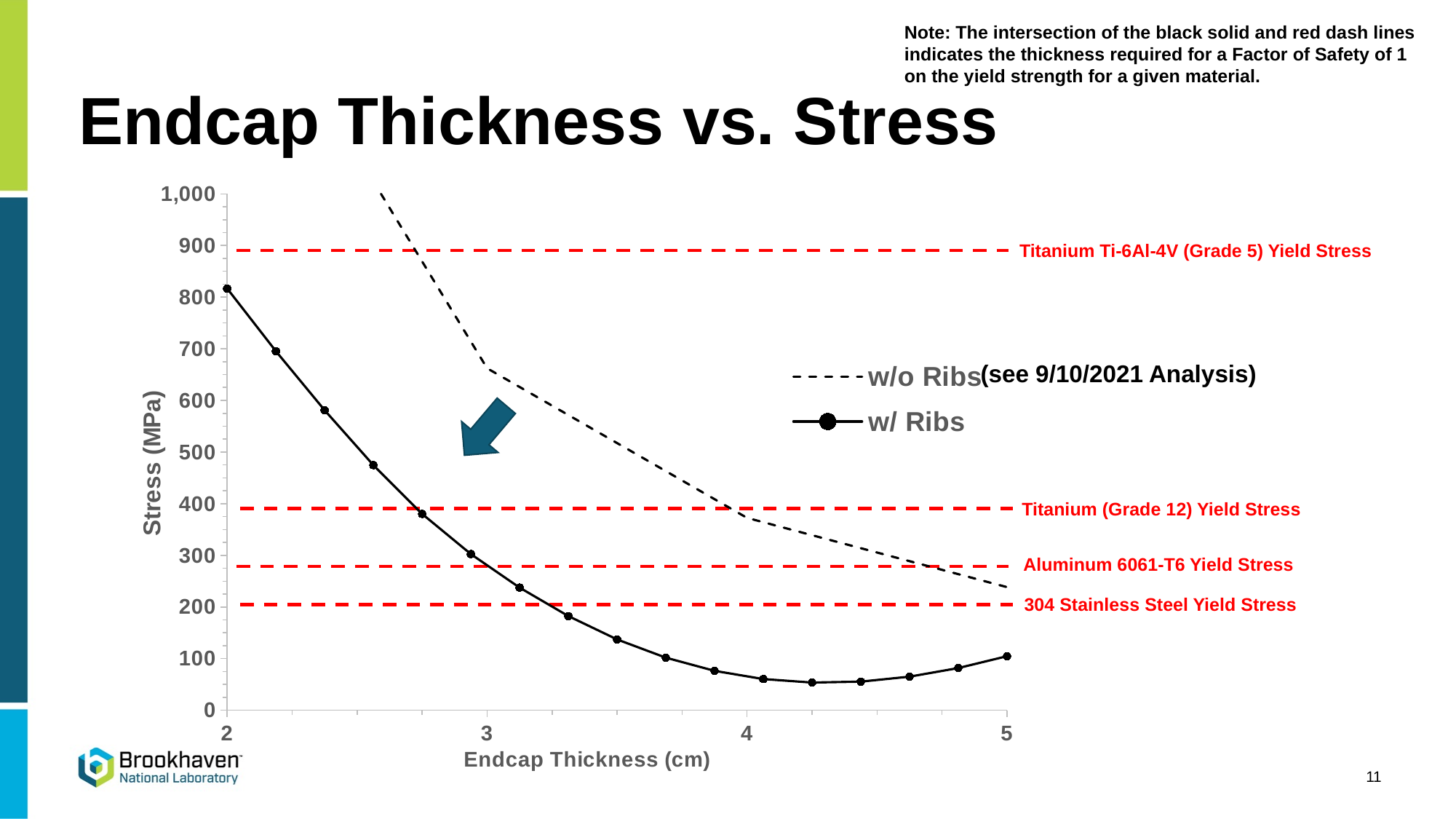
What kind of chart is shown on the slide? line chart Does the w/ Ribs stress rise or fall as endcap thickness increases from 2 cm to 4 cm? fall How many series does the chart legend list? 2 Is the w/ Ribs stress at an endcap thickness of 2 cm greater or less than 700 MPa? greater Is the w/o Ribs stress at an endcap thickness of 5 cm greater or less than 200 MPa? greater Is the lowest stress reached by the w/ Ribs series greater or less than 100 MPa? less Does the w/o Ribs stress rise or fall as endcap thickness increases from 3 cm to 5 cm? fall At an endcap thickness of 4 cm, which series shows the higher stress, w/o Ribs or w/ Ribs? w/o Ribs What is the title of the chart's x axis? Endcap Thickness (cm) What are the two series named in the chart legend? w/o Ribs and w/ Ribs Which material's yield stress line is the highest on the chart? Titanium Ti-6Al-4V (Grade 5)